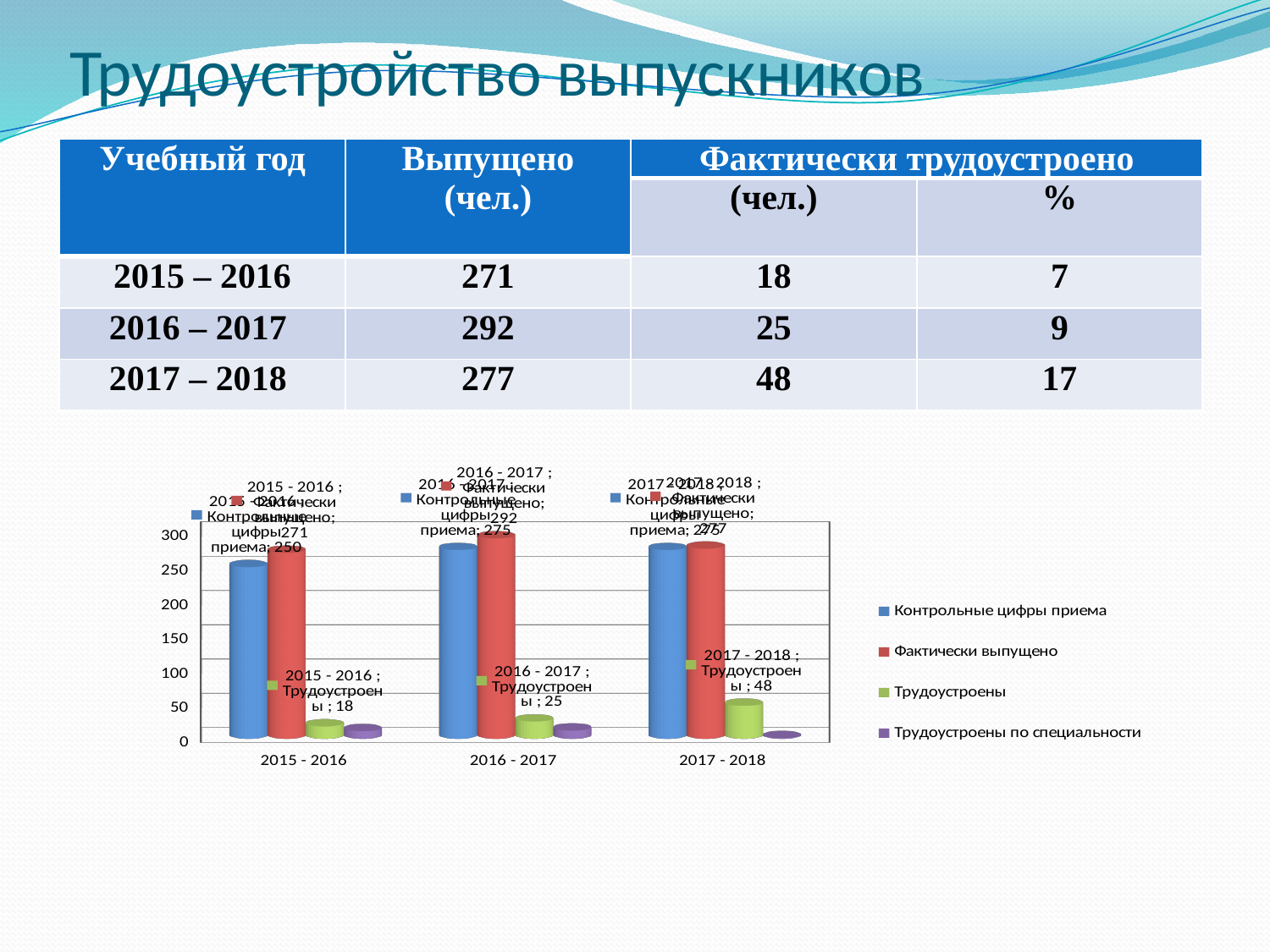
What is the value of Трудоустроены for 2015 - 2016 in the chart? 18 What is the difference between the Трудоустроены values for 2017 - 2018 and 2015 - 2016? 30 Which academic year has the lowest value for Трудоустроены in the chart? 2015 - 2016 How many academic-year categories are shown on the x axis of the chart? 3 Which academic year has the highest value for Трудоустроены in the chart? 2017 - 2018 Which is larger, the Трудоустроены value for 2016 - 2017 or for 2017 - 2018? 2017 - 2018 What is the value of Контрольные цифры приема for 2015 - 2016 in the chart? 250 Is the value of Трудоустроены по специальности for 2015 - 2016 greater or less than 50? less How many series does the chart legend list? 4 What kind of chart is shown on the slide? bar chart Do the Трудоустроены values rise or fall from 2015 - 2016 to 2017 - 2018? rise What is the value of Трудоустроены for 2017 - 2018 in the chart? 48